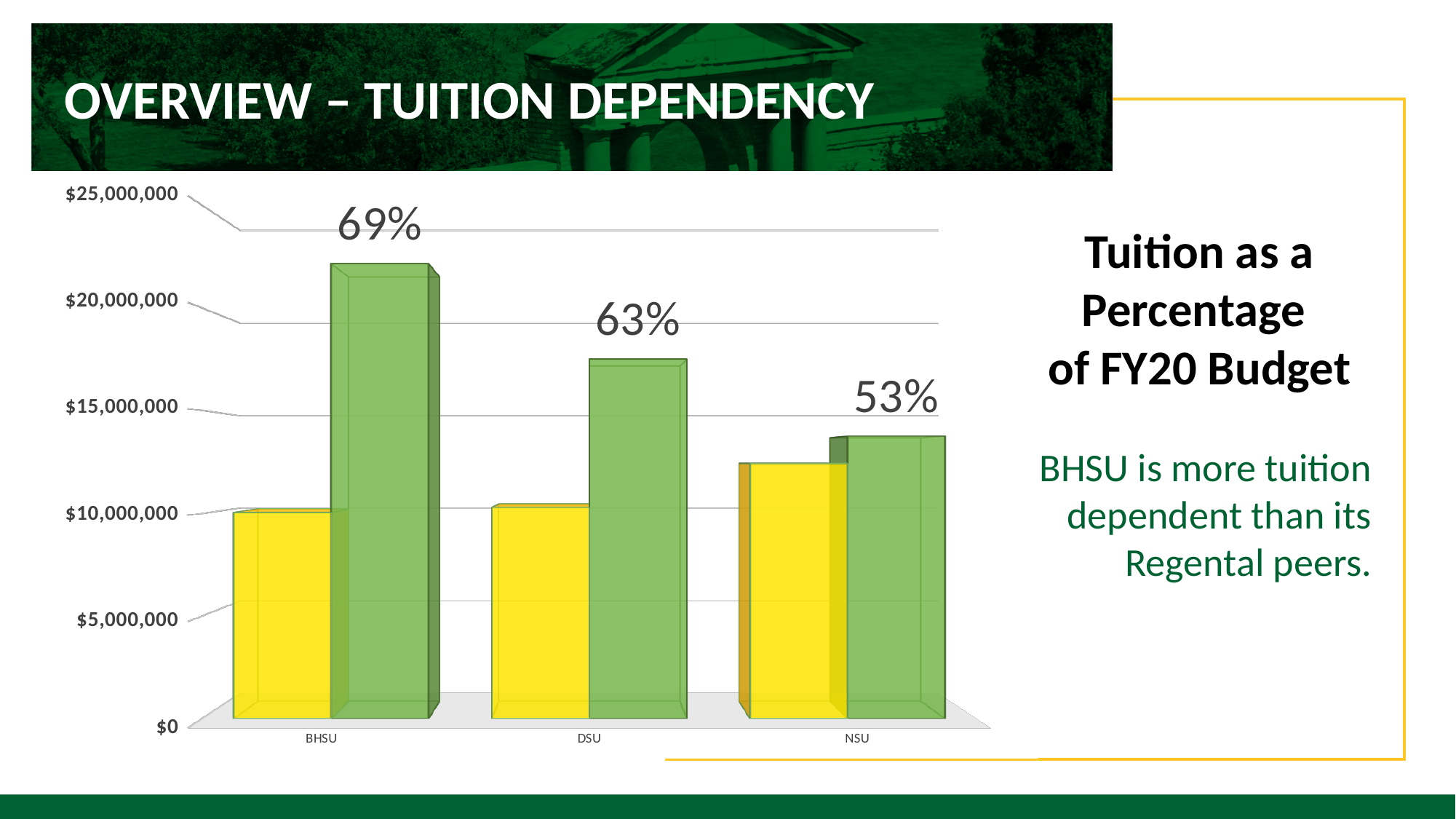
What percentage label is shown above the NSU bars? 53% Which category has the highest percentage label? BHSU How many categories are shown on the x axis? 3 What percentage label is shown above the DSU bars? 63% What kind of chart is shown on the slide? Bar chart Which category has the lowest percentage label? NSU Is the green bar for NSU greater or less than $15,000,000? less What is the difference between the percentage labels for BHSU and DSU? 6% What is the difference between the percentage labels for BHSU and NSU? 16% Is the green bar for BHSU greater or less than $20,000,000? greater Do the percentage labels rise or fall from BHSU to NSU along the x axis? Fall What percentage label is shown above the BHSU bars? 69%